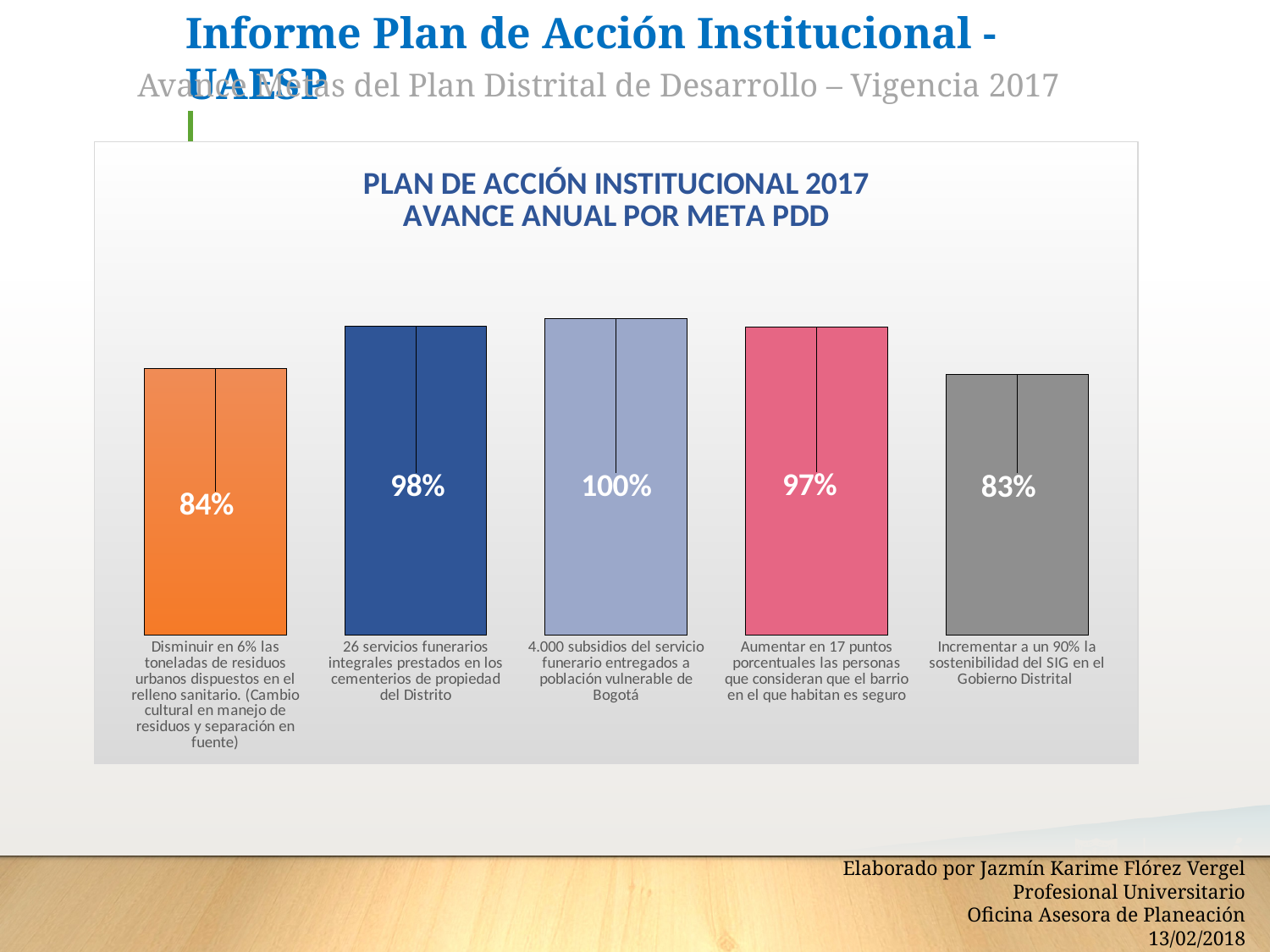
What is the value for the bar labelled '26 servicios funerarios integrales prestados en los cementerios de propiedad del Distrito'? 98% What is the value for the bar labelled 'Incrementar a un 90% la sostenibilidad del SIG en el Gobierno Distrital'? 83% Which category has the highest value? 4.000 subsidios del servicio funerario entregados a población vulnerable de Bogotá What is the value for the bar labelled 'Aumentar en 17 puntos porcentuales las personas que consideran que el barrio en el que habitan es seguro'? 97% How many categories are shown in the chart? 5 What is the title of the chart? PLAN DE ACCIÓN INSTITUCIONAL 2017 AVANCE ANUAL POR META PDD What is the difference between the value for '4.000 subsidios del servicio funerario entregados a población vulnerable de Bogotá' and the value for 'Incrementar a un 90% la sostenibilidad del SIG en el Gobierno Distrital'? 17% Which category has the lowest value? Incrementar a un 90% la sostenibilidad del SIG en el Gobierno Distrital What colour is the bar for '4.000 subsidios del servicio funerario entregados a población vulnerable de Bogotá'? Light blue What kind of chart is shown on the slide? Bar chart What is the difference between the value for '26 servicios funerarios integrales prestados en los cementerios de propiedad del Distrito' and the value for 'Disminuir en 6% las toneladas de residuos urbanos dispuestos en el relleno sanitario'? 14% Which is larger: the value for 'Disminuir en 6% las toneladas de residuos urbanos dispuestos en el relleno sanitario' or the value for 'Incrementar a un 90% la sostenibilidad del SIG en el Gobierno Distrital'? Disminuir en 6% las toneladas de residuos urbanos dispuestos en el relleno sanitario